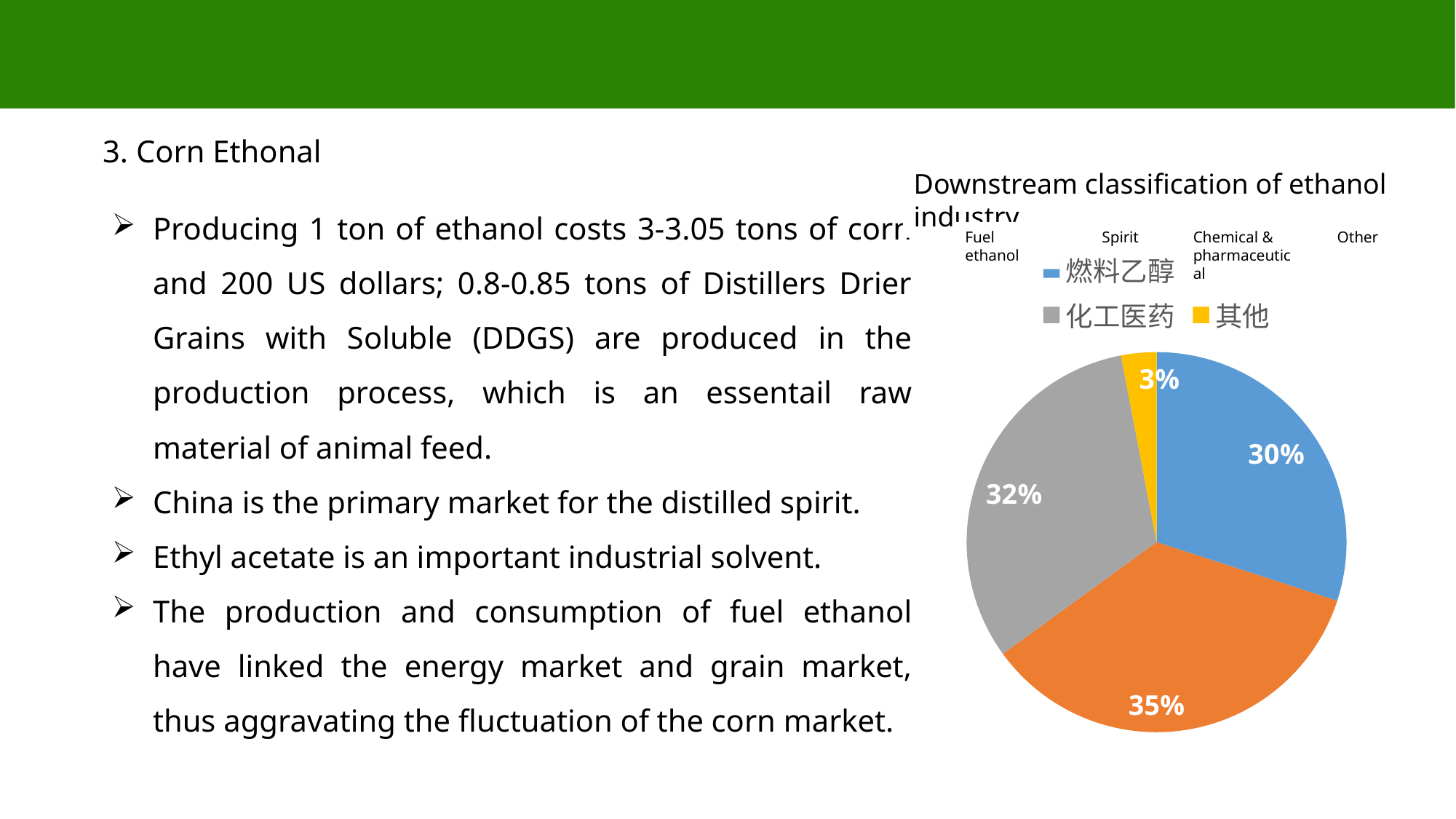
What is the title of the chart on the slide? Downstream classification of ethanol industry Which category has the smallest slice of the pie? Other How many slices does the pie chart have? 4 What share of the pie does Fuel ethanol account for? 30% Which is larger, the Chemical & pharmaceutical slice or the Fuel ethanol slice? Chemical & pharmaceutical What share of the pie does Other account for? 3% What share of the pie does Spirit account for? 35% What is the difference in percentage points between the Spirit slice and the Fuel ethanol slice? 5% What share of the pie does Chemical & pharmaceutical account for? 32% Which category has the largest slice of the pie? Spirit What colour is the Other slice in the pie chart? yellow What kind of chart is shown on the slide? pie chart